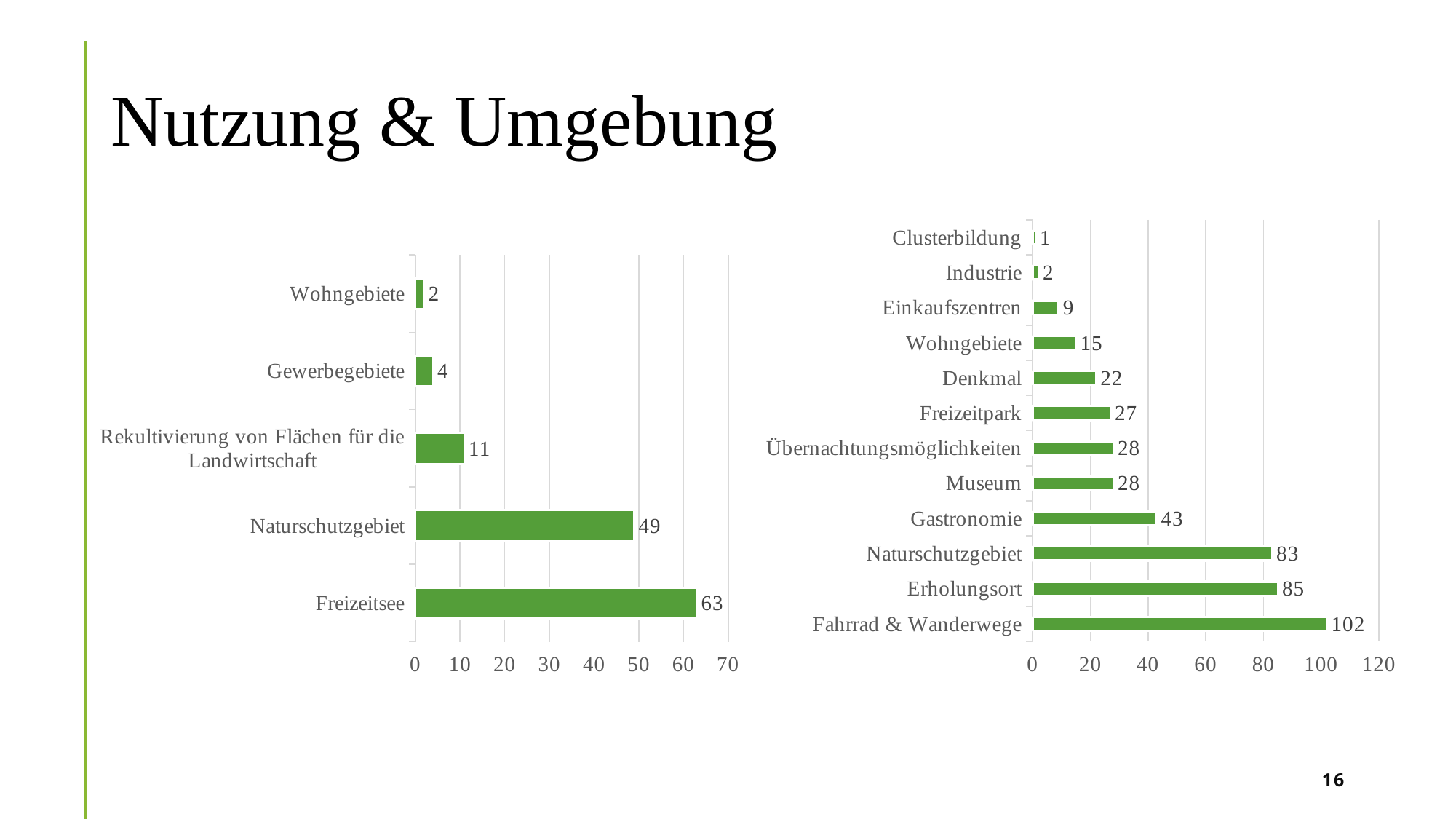
In the left chart, what is the value for Rekultivierung von Flächen für die Landwirtschaft? 11 In the left chart, what is the value for Freizeitsee? 63 In the right chart, which category has the lowest value? Clusterbildung In the left chart, what is the difference between Freizeitsee and Naturschutzgebiet? 14 In the right chart, what is the difference between Fahrrad & Wanderwege and Erholungsort? 17 In the left chart, which category has the lowest value? Wohngebiete In the right chart, what is the value for Gastronomie? 43 In the right chart, which category has the highest value? Fahrrad & Wanderwege In the right chart, which is larger: Erholungsort or Naturschutzgebiet? Erholungsort In the left chart, how many categories are shown? 5 What kind of chart is the right chart? Bar chart In the right chart, how many categories are shown? 12